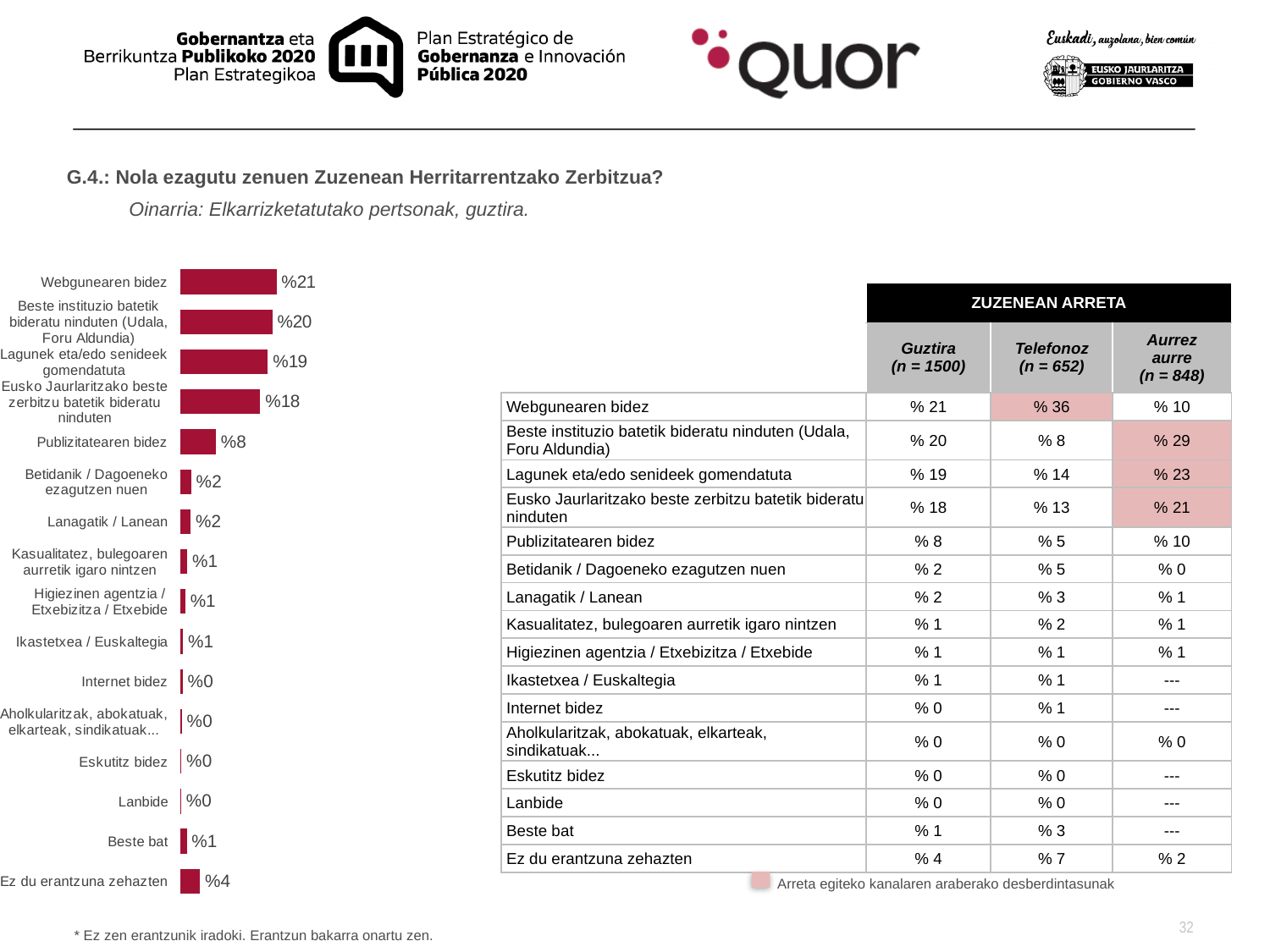
What value does the bar chart show for Ez du erantzuna zehazten? %4 What is the difference between the values for Webgunearen bidez and Publizitatearen bidez in the bar chart? 13 What value does the bar chart show for Lanbide? %0 Which category has the highest value in the bar chart? Webgunearen bidez What value does the bar chart show for Lagunek eta/edo senideek gomendatuta? %19 In the bar chart, which is larger: the value for Publizitatearen bidez or the value for Ez du erantzuna zehazten? Publizitatearen bidez How many categories are shown in the bar chart? 16 What kind of chart is shown on the left of the slide? Bar chart What value does the bar chart show for Webgunearen bidez? %21 What value does the bar chart show for Publizitatearen bidez? %8 In the bar chart, which is larger: the value for Webgunearen bidez or the value for Eusko Jaurlaritzako beste zerbitzu batetik bideratu ninduten? Webgunearen bidez What is the difference between the values for Lagunek eta/edo senideek gomendatuta and Ez du erantzuna zehazten in the bar chart? 15